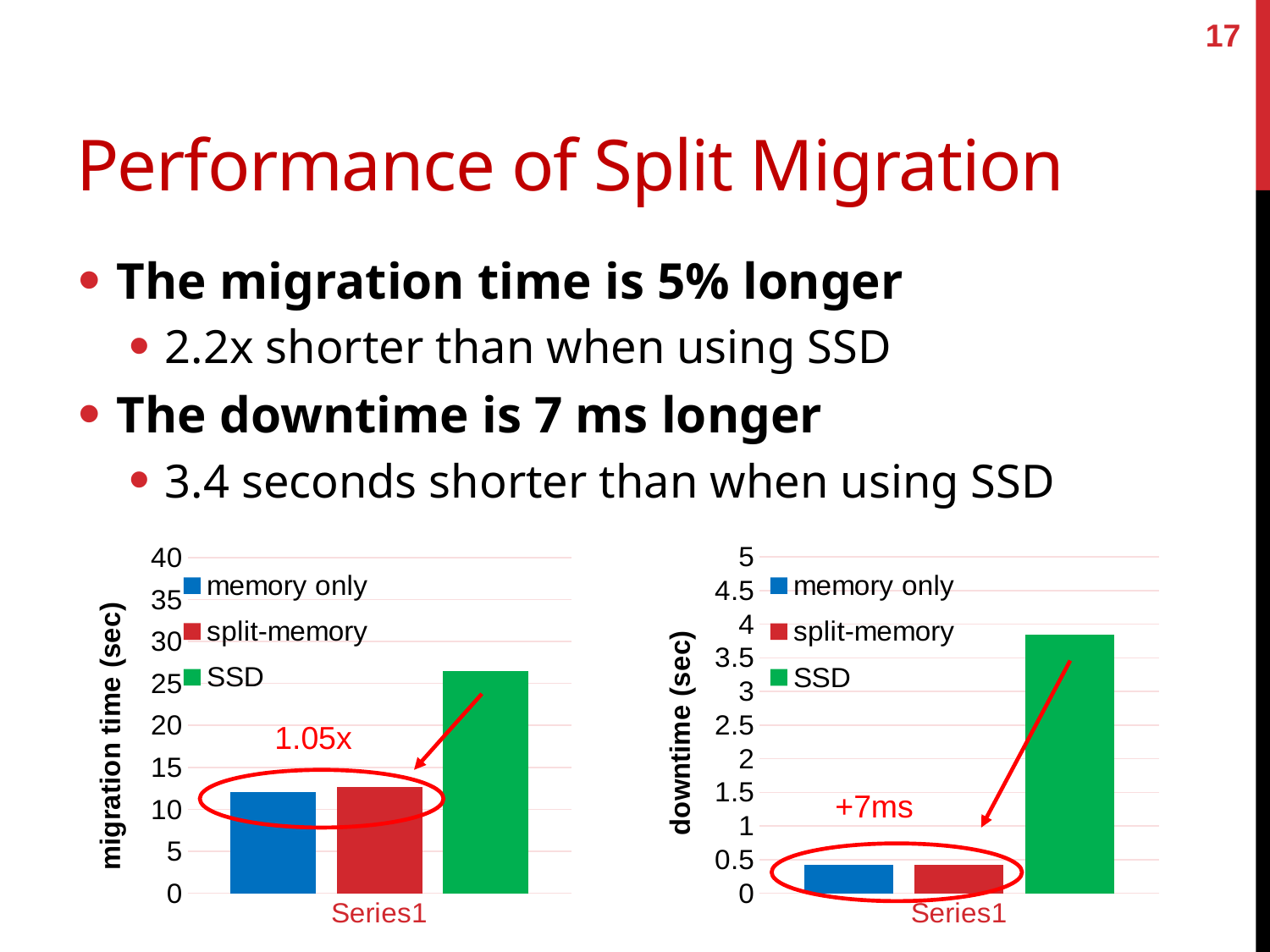
In the left chart (migration time), which is larger: the value for split-memory or the value for SSD? SSD In the right chart (downtime), is the value for split-memory greater or less than 1? less In the left chart (migration time), is the value for memory only greater or less than 15? less In the left chart (migration time), which series has the highest value? SSD What is the y-axis label of the left chart? migration time (sec) What kind of chart is the left chart (migration time)? bar chart How many series does the legend of the right chart (downtime) list? 3 In the right chart (downtime), which is larger: the value for SSD or the value for memory only? SSD In the left chart (migration time), is the value for SSD greater or less than 20? greater In the right chart (downtime), which series has the highest value? SSD What annotation text is written above the circled bars in the right chart (downtime)? +7ms